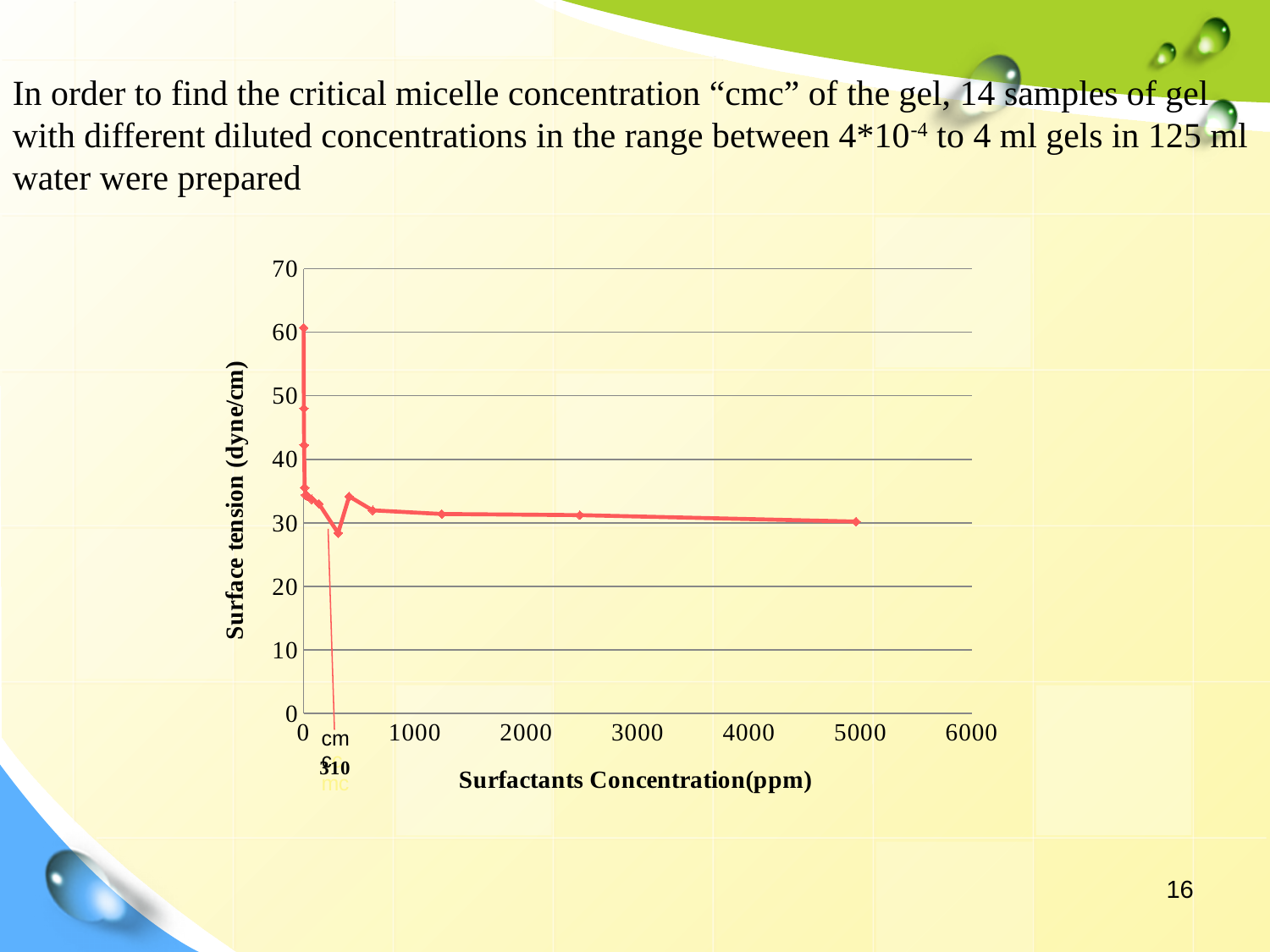
Is the surface tension at 5000 ppm greater or less than 20 dyne/cm? greater What kind of chart is shown on the slide? line chart Is the highest surface tension value plotted greater or less than 50 dyne/cm? greater What is the maximum value shown on the x axis of the chart? 6000 Is the surface tension at about 2500 ppm greater or less than 40 dyne/cm? less Overall, does surface tension rise or fall as surfactant concentration increases along the x axis? fall What is the title of the y axis of the chart? Surface tension (dyne/cm) What is the title of the x axis of the chart? Surfactants Concentration(ppm) Which has the higher surface tension: the point near 0 ppm or the point at 5000 ppm? the point near 0 ppm How many data series are plotted on the chart? 1